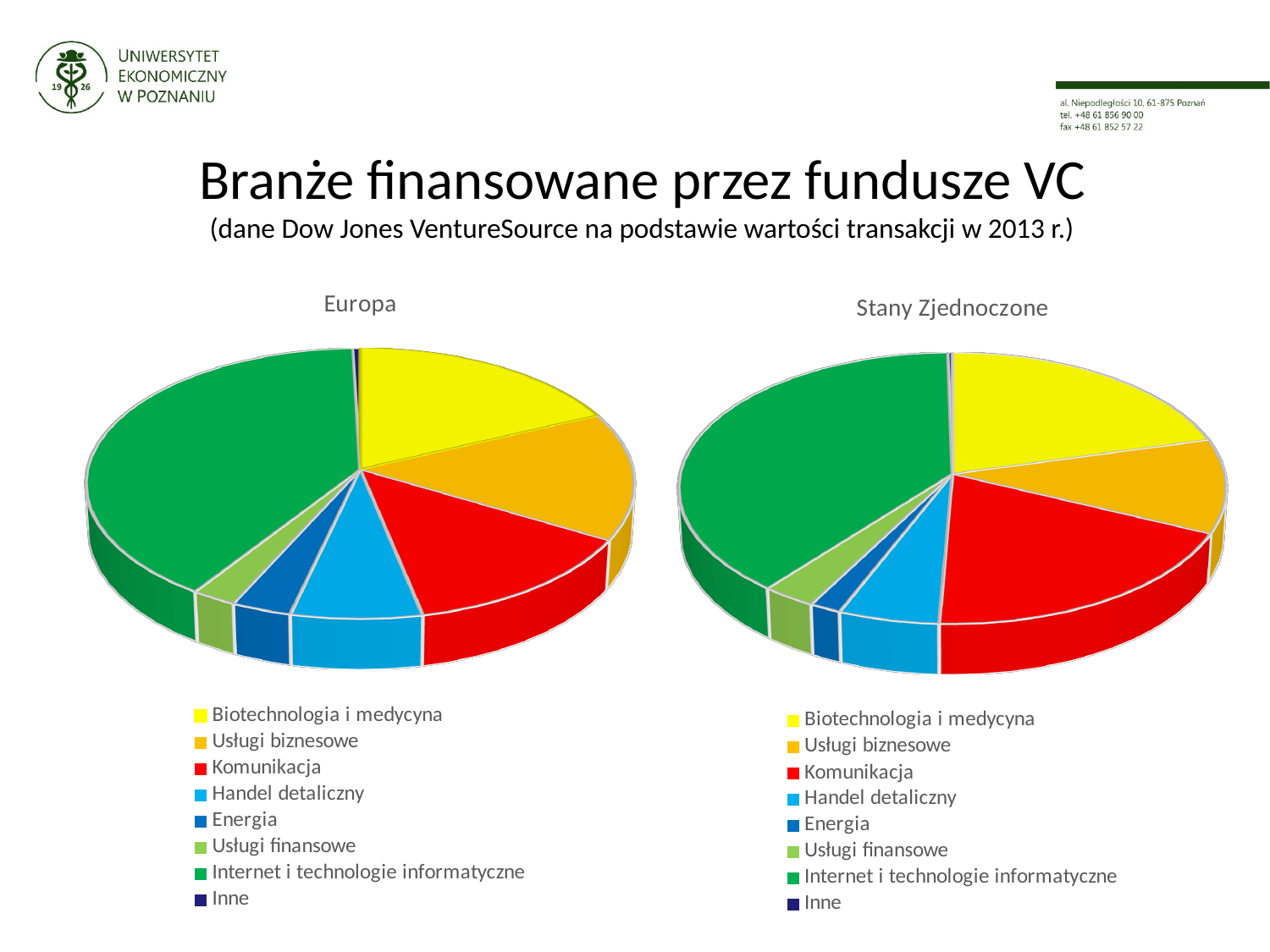
In the "Stany Zjednoczone" chart, how many categories does the legend list? 8 What kind of chart is the "Stany Zjednoczone" chart? pie chart In the "Europa" chart, which category has the smallest slice? Inne In the "Europa" chart, how many categories does the legend list? 8 In the "Stany Zjednoczone" chart, which slice is larger: Biotechnologia i medycyna or Usługi finansowe? Biotechnologia i medycyna In the "Stany Zjednoczone" chart, which category has the smallest slice? Inne In the "Stany Zjednoczone" chart, which category has the largest slice? Internet i technologie informatyczne What is the main title of the slide above the two charts? Branże finansowane przez fundusze VC In the "Europa" chart, which colour represents Komunikacja in the legend? red What kind of chart is the "Europa" chart? pie chart In the "Europa" chart, which slice is larger: Komunikacja or Energia? Komunikacja In the "Europa" chart, which category has the largest slice? Internet i technologie informatyczne